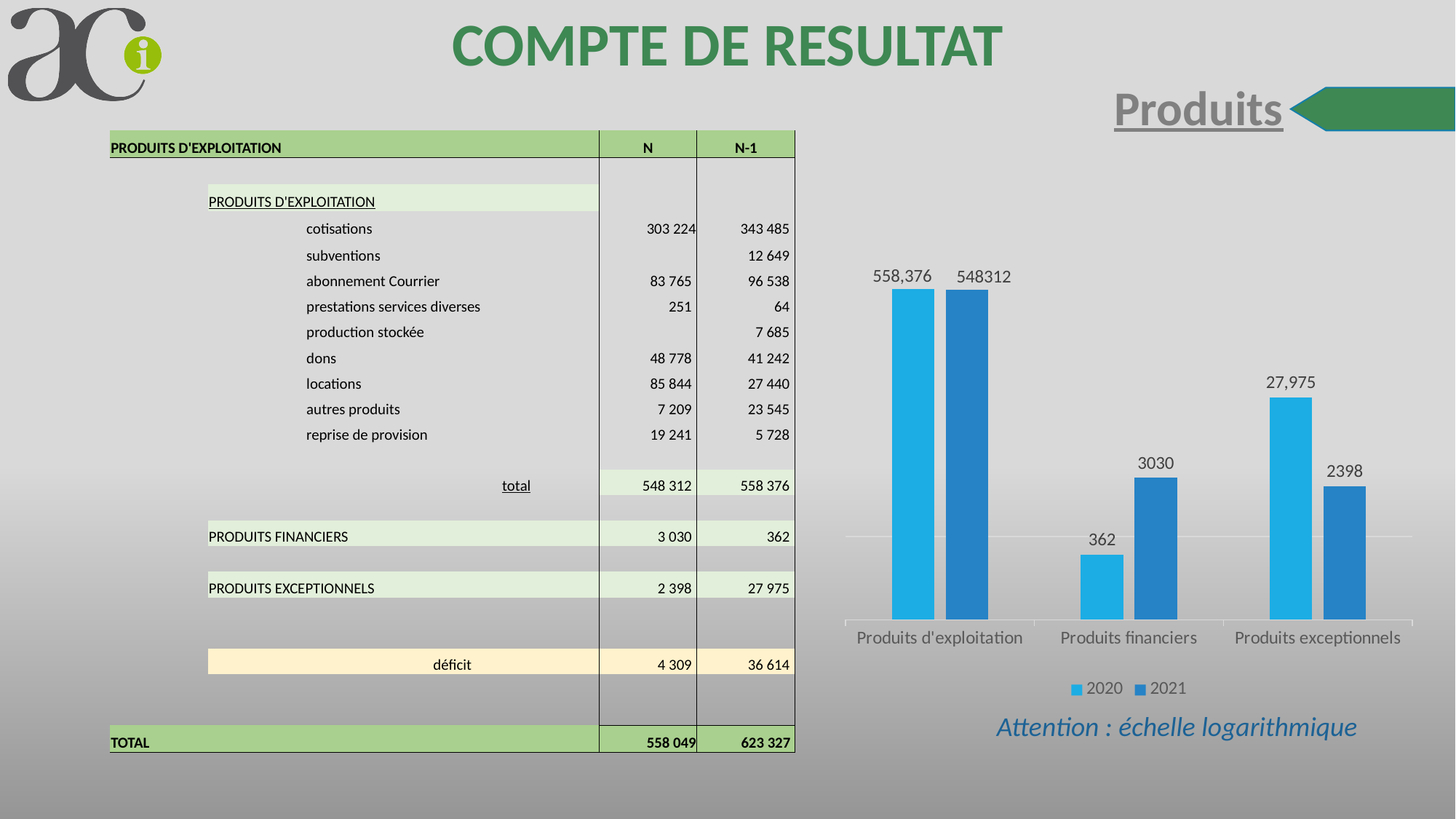
For Produits exceptionnels, which series has the larger value, 2020 or 2021? 2020 What is the value for Produits exceptionnels in the 2020 series? 27,975 What is the difference between the 2020 and 2021 values for Produits exceptionnels? 25,577 How many series does the chart's legend list? 2 Which category has the highest value in the 2021 series? Produits d'exploitation How many categories are shown on the x axis of the chart? 3 What is the value for Produits exceptionnels in the 2021 series? 2398 What kind of chart is shown on the slide? Bar chart Which category has the lowest value in the 2020 series? Produits financiers What is the difference between the 2021 and 2020 values for Produits financiers? 2668 What is the value for Produits d'exploitation in the 2020 series? 558,376 What is the value for Produits financiers in the 2021 series? 3030